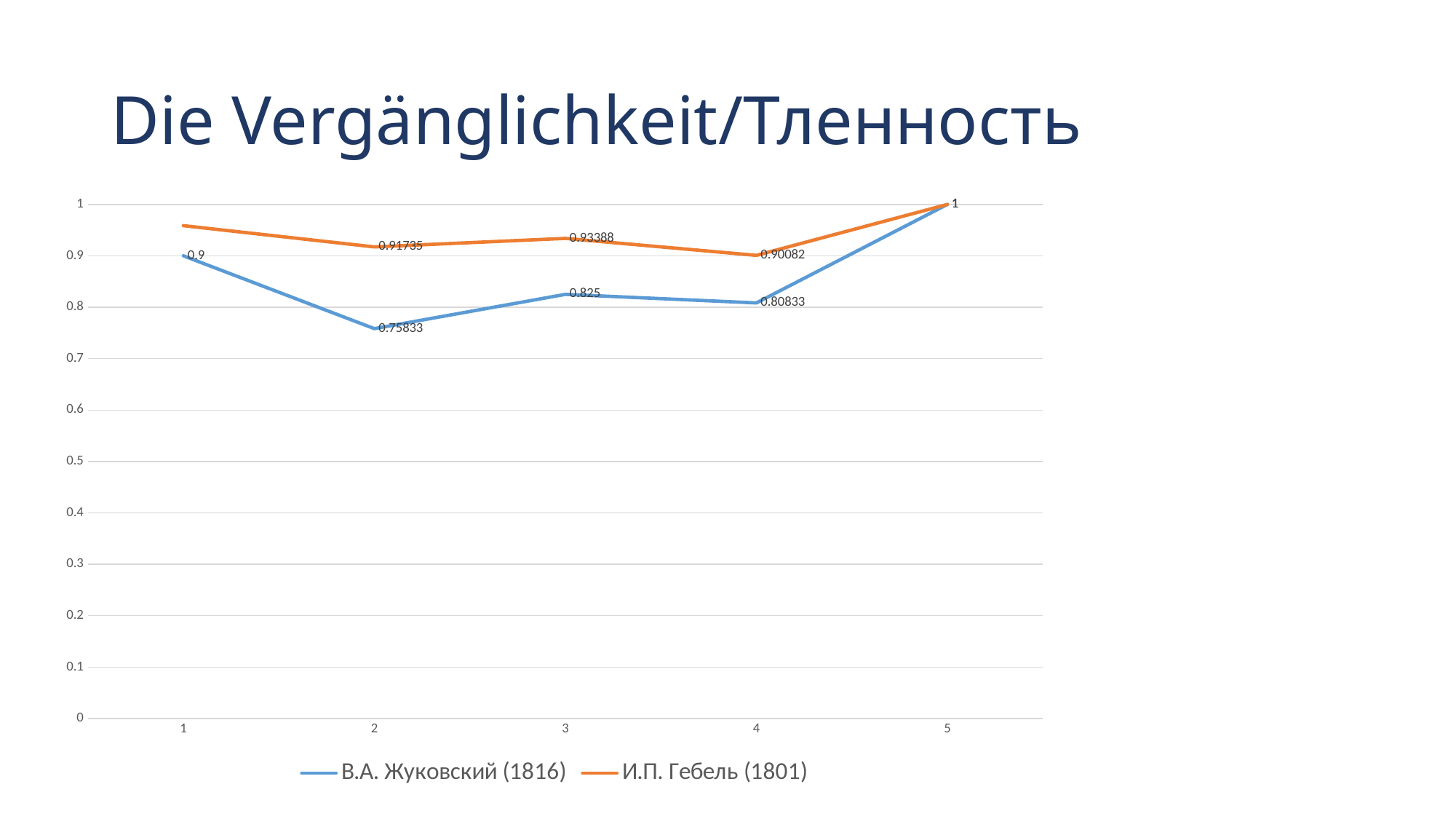
Which colour is used for the В.А. Жуковский (1816) line? blue What is the difference between the two series at point 4? 0.09249 What is the value for И.П. Гебель (1801) at point 4? 0.90082 How many points are plotted along the x axis for each series? 5 What is the value for В.А. Жуковский (1816) at point 2? 0.75833 What is the value for В.А. Жуковский (1816) at point 1? 0.9 Is the value for И.П. Гебель (1801) at point 1 greater or less than 0.9? greater What is the value for И.П. Гебель (1801) at point 3? 0.93388 How many series does the legend list? 2 Which series has the larger value at point 2? И.П. Гебель (1801) What kind of chart is shown on the slide? line chart At which point is the value for В.А. Жуковский (1816) lowest? 2